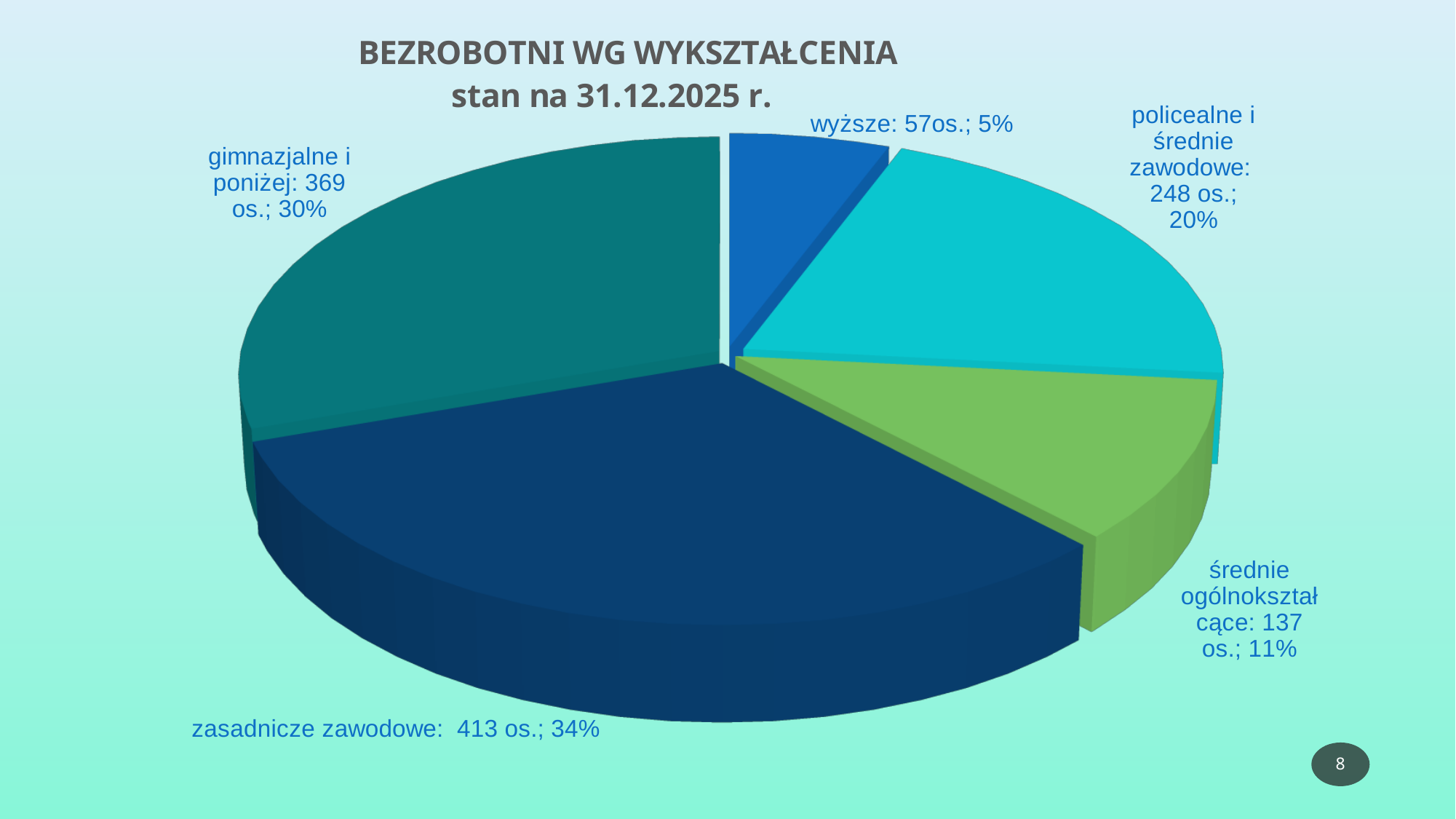
Which category has the smallest slice? wyższe What is the difference in number of people between 'gimnazjalne i poniżej' and 'średnie ogólnokształcące'? 232 How many people are in the 'zasadnicze zawodowe' category? 413 os. What kind of chart is shown on the slide? pie chart What is the total number of people across all five categories? 1224 What is the title of the chart? BEZROBOTNI WG WYKSZTAŁCENIA stan na 31.12.2025 r. How many people are in the 'wyższe' category? 57 os. Which is larger: 'gimnazjalne i poniżej' or 'policealne i średnie zawodowe'? gimnazjalne i poniżej What percentage share does 'policealne i średnie zawodowe' have? 20% Which category has the largest slice? zasadnicze zawodowe What percentage share does 'średnie ogólnokształcące' have? 11% How many slices does the pie chart have? 5